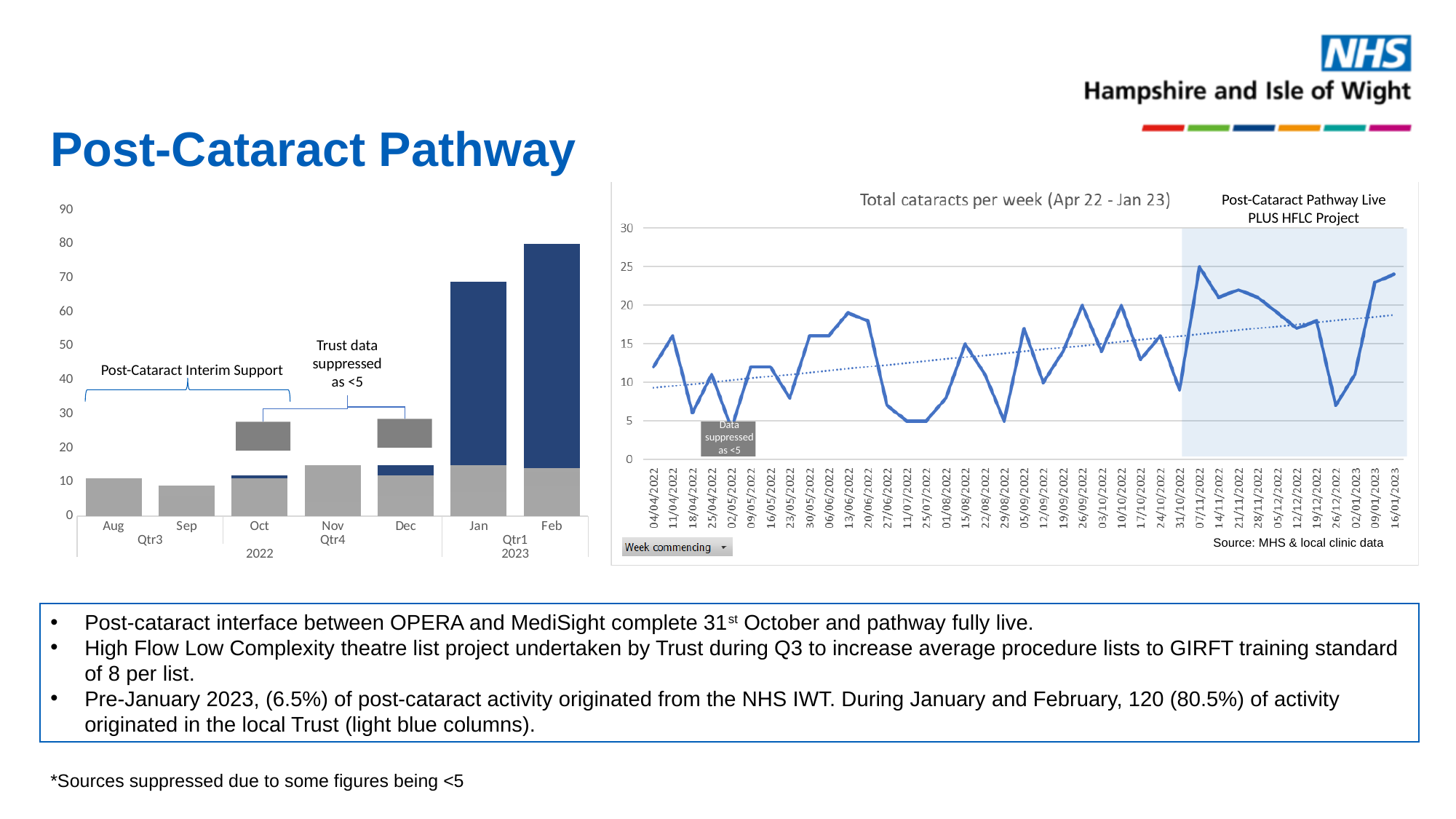
In the left-hand bar chart, how many months are shown on the x axis? 7 What label is given to the shaded region at the right of the 'Total cataracts per week' chart? Post-Cataract Pathway Live PLUS HFLC Project In the 'Total cataracts per week' chart, does the dotted trend line rise or fall from left to right? rises In the left-hand bar chart, which month has the tallest bar? Feb In the left-hand bar chart, is the value for Sep greater or less than 10? less In the 'Total cataracts per week' chart, which week commencing date has the highest value? 07/11/2022 In the left-hand bar chart, which is larger, the bar for Jan or the bar for Nov? Jan What kind of chart is the 'Total cataracts per week (Apr 22 - Jan 23)' chart? line chart In the left-hand bar chart, is the total for Feb greater or less than 70? greater In the 'Total cataracts per week' chart, is the value for week commencing 26/12/2022 greater or less than 10? less What kind of chart is the left-hand chart showing monthly values from Aug to Feb? bar chart In the left-hand bar chart, which month has the shortest bar? Sep